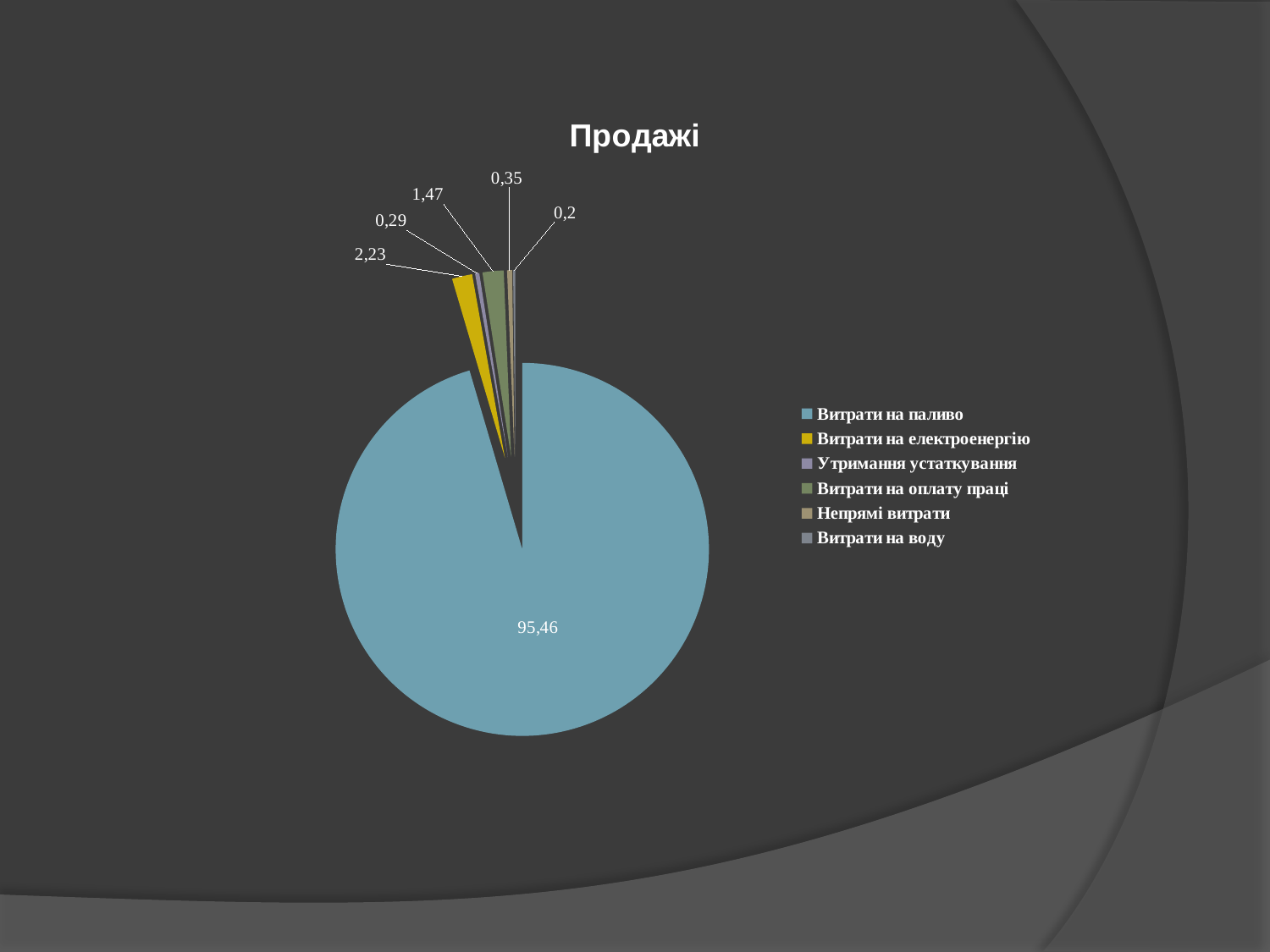
Which category has the smallest slice? Витрати на воду What is the difference between the values for Витрати на електроенергію and Витрати на оплату праці? 0,76 What is the value for Витрати на воду? 0,2 Which is larger, Утримання устаткування or Непрямі витрати? Непрямі витрати What is the value for Непрямі витрати? 0,35 How many categories does the pie chart have? 6 What is the value for Витрати на оплату праці? 1,47 What type of chart is shown on the slide? pie chart What is the title of the chart? Продажі What is the value for Витрати на паливо? 95,46 What is the value for Витрати на електроенергію? 2,23 Which category has the largest slice? Витрати на паливо